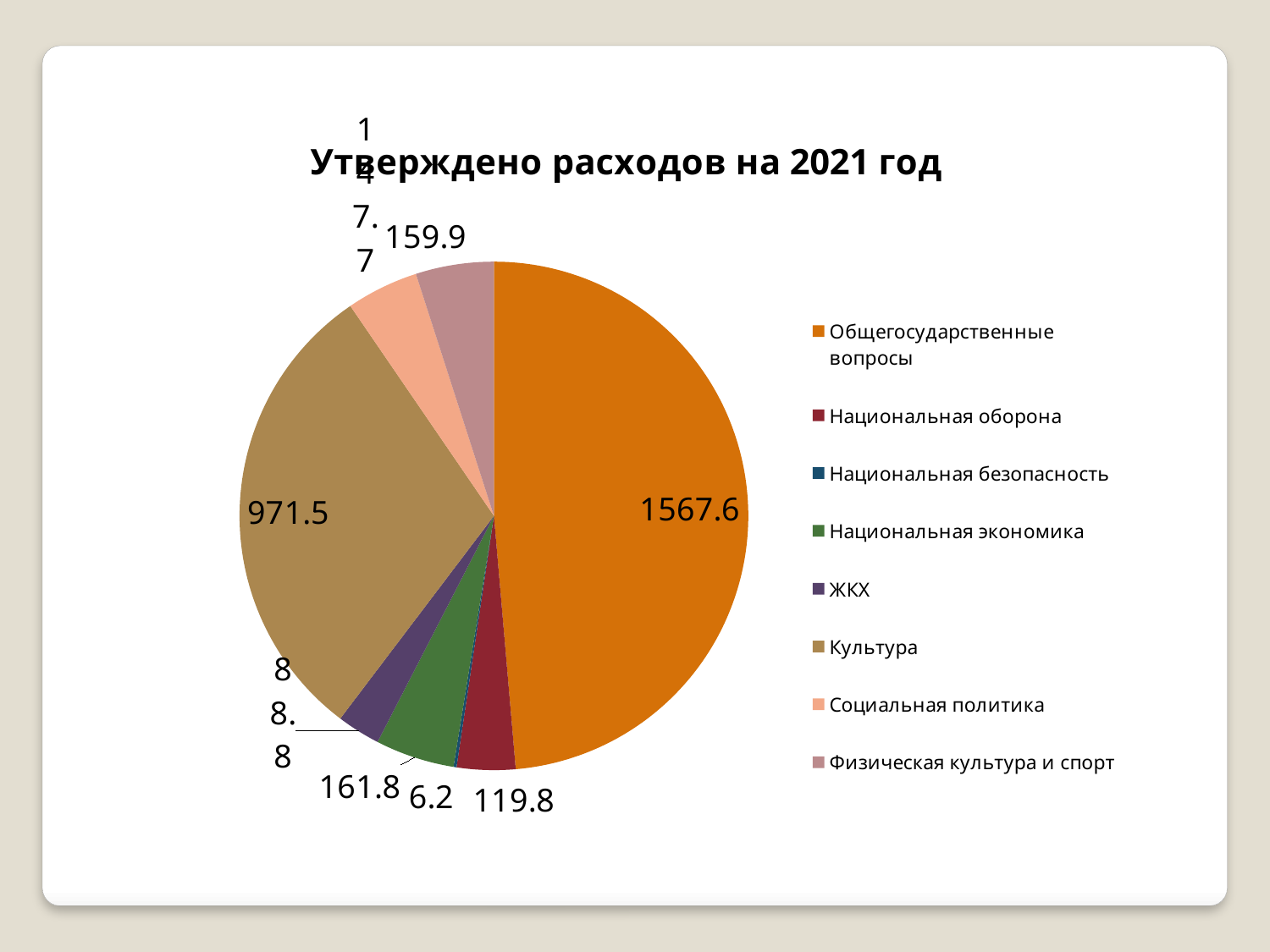
What is the difference between the values for Общегосударственные вопросы and Культура? 596.1 What kind of chart is shown on the slide? pie chart What is the value for Общегосударственные вопросы? 1567.6 Which category has the largest slice of the pie? Общегосударственные вопросы What is the value for Культура? 971.5 What is the value for Национальная экономика? 161.8 What is the value for Физическая культура и спорт? 159.9 How many categories does the legend list? 8 What is the value for Национальная безопасность? 6.2 What is the title of the chart? Утверждено расходов на 2021 год Which category has the smallest slice of the pie? Национальная безопасность What is the value for Национальная оборона? 119.8